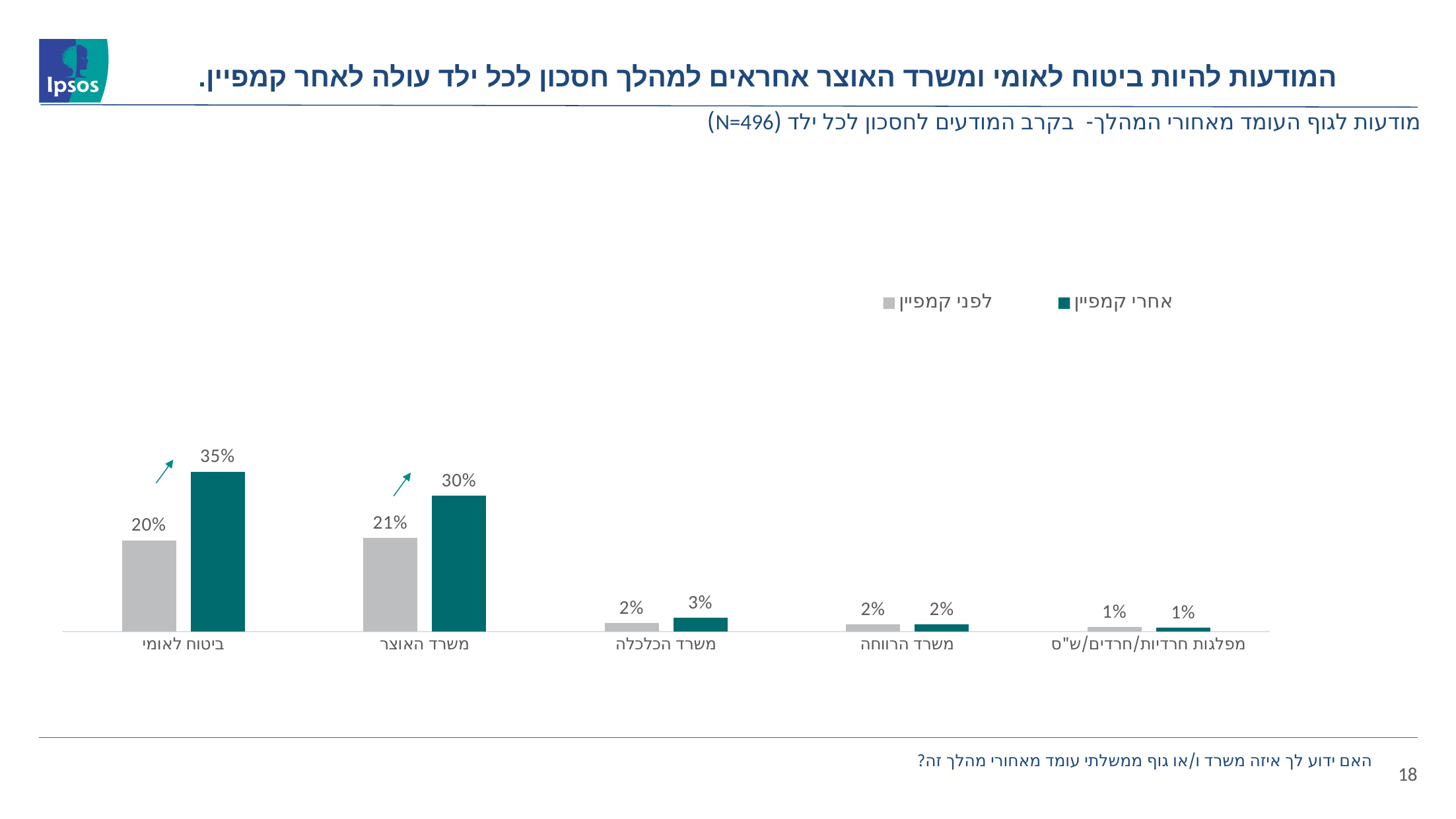
What is the value for מפלגות חרדיות/חרדים/ש"ס in the לפני קמפיין series? 1% What is the value for משרד האוצר in the לפני קמפיין series? 21% What is the difference between the אחרי קמפיין and לפני קמפיין values for ביטוח לאומי? 15% What kind of chart is shown on the slide? Bar chart Which category has the lowest value in the לפני קמפיין series? מפלגות חרדיות/חרדים/ש"ס How many series does the chart's legend list? 2 How many categories are shown on the x axis of the chart? 5 Which is larger: the אחרי קמפיין value for ביטוח לאומי or the אחרי קמפיין value for משרד האוצר? ביטוח לאומי What is the value for משרד הכלכלה in the אחרי קמפיין series? 3% Which category has the highest value in the אחרי קמפיין series? ביטוח לאומי What is the value for ביטוח לאומי in the אחרי קמפיין series? 35% What is the difference between the אחרי קמפיין and לפני קמפיין values for משרד האוצר? 9%